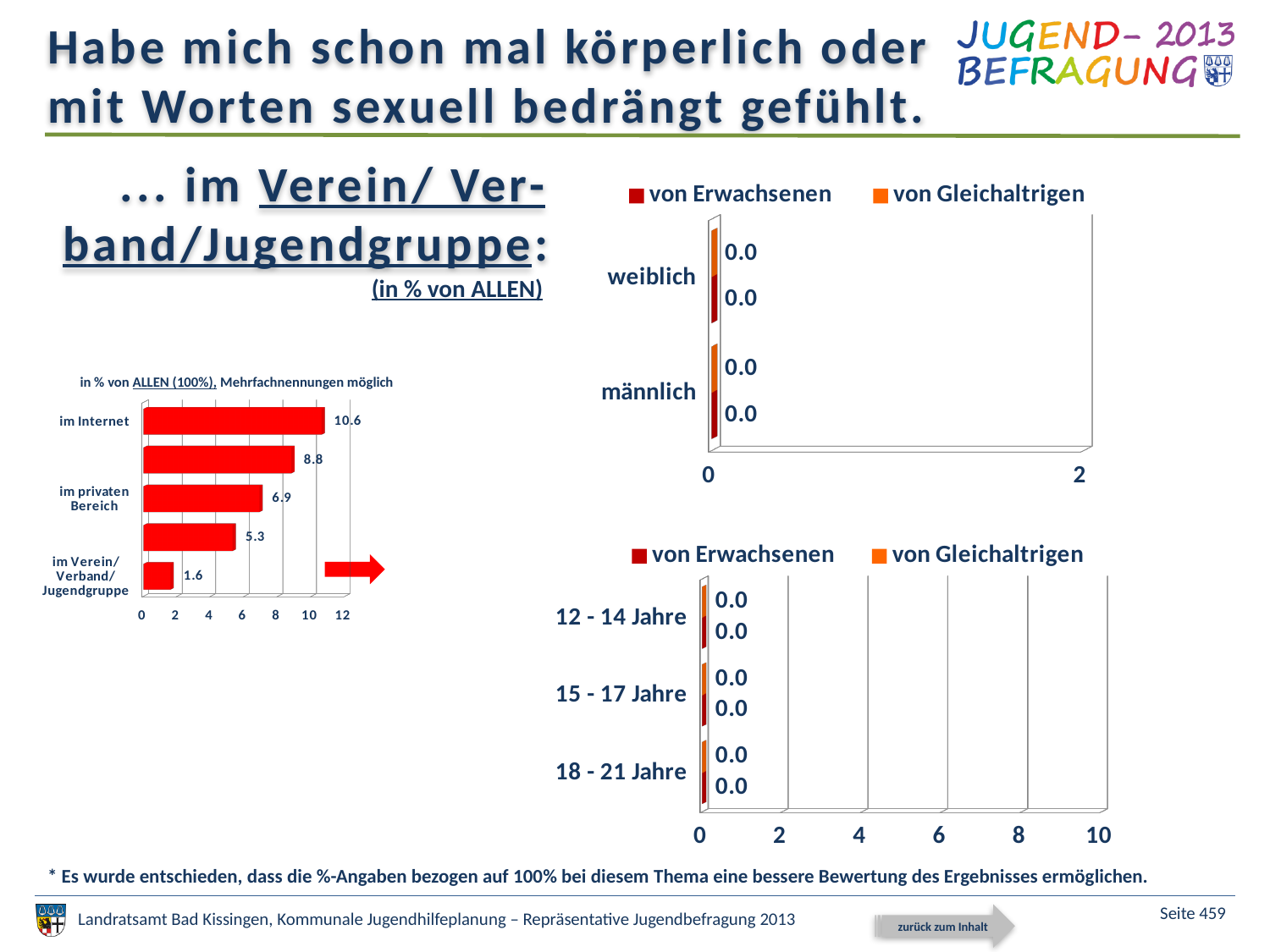
What kind of chart is the bottom right chart (age groups)? bar chart In the small bar chart on the left, what is the value for 'im privaten Bereich'? 6.9 In the bottom right chart (age groups), what is the value for 'von Gleichaltrigen' for '15 - 17 Jahre'? 0.0 In the top right chart (weiblich/männlich), what is the value for 'von Erwachsenen' for 'weiblich'? 0.0 In the top right chart (weiblich/männlich), how many series does the legend list? 2 In the small bar chart on the left, which labelled category has the highest value? im Internet In the bottom right chart (age groups), how many age categories are shown? 3 In the small bar chart on the left, how many bars are plotted? 5 In the small bar chart on the left, which labelled category has the lowest value? im Verein/ Verband/ Jugendgruppe In the small bar chart on the left, what is the value for 'im Verein/ Verband/ Jugendgruppe'? 1.6 In the small bar chart on the left, what is the value for 'im Internet'? 10.6 In the small bar chart on the left, what is the difference between the values for 'im Internet' and 'im Verein/ Verband/ Jugendgruppe'? 9.0